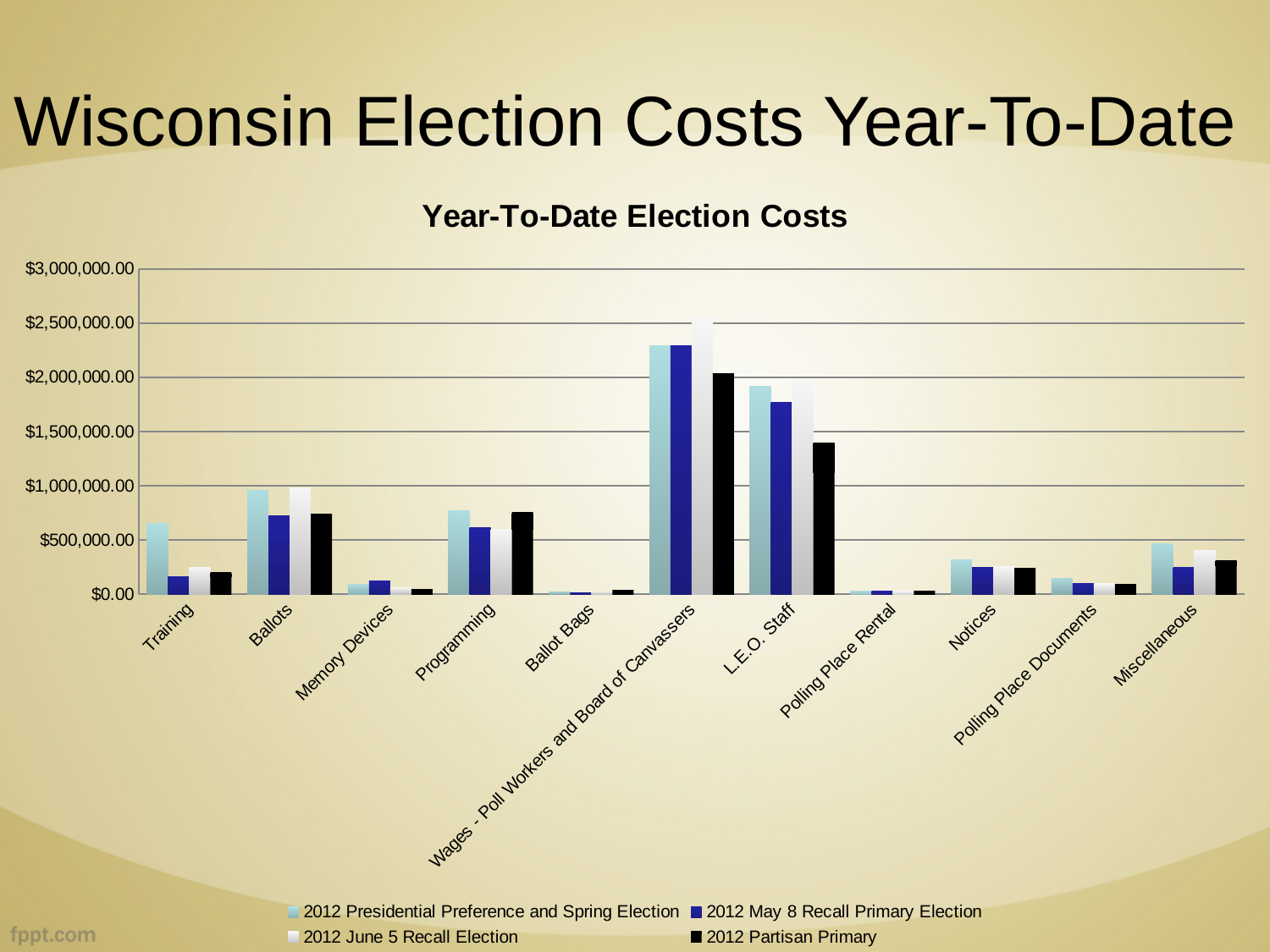
How many cost categories are shown along the x axis? 11 Is the value for Wages - Poll Workers and Board of Canvassers in the 2012 June 5 Recall Election greater or less than $2,500,000.00? greater For the 2012 Partisan Primary, which is larger: Wages - Poll Workers and Board of Canvassers or L.E.O. Staff? Wages - Poll Workers and Board of Canvassers Which cost category has the highest bars overall? Wages - Poll Workers and Board of Canvassers Is the value for Memory Devices in the 2012 Presidential Preference and Spring Election greater or less than $500,000.00? less Is the value for Training in the 2012 Presidential Preference and Spring Election greater or less than $500,000.00? greater For the 2012 June 5 Recall Election, which is larger: Ballots or Training? Ballots Which series is shown in black? 2012 Partisan Primary What is the title of the chart? Year-To-Date Election Costs How many series does the legend list? 4 What kind of chart is shown on the slide? Bar chart